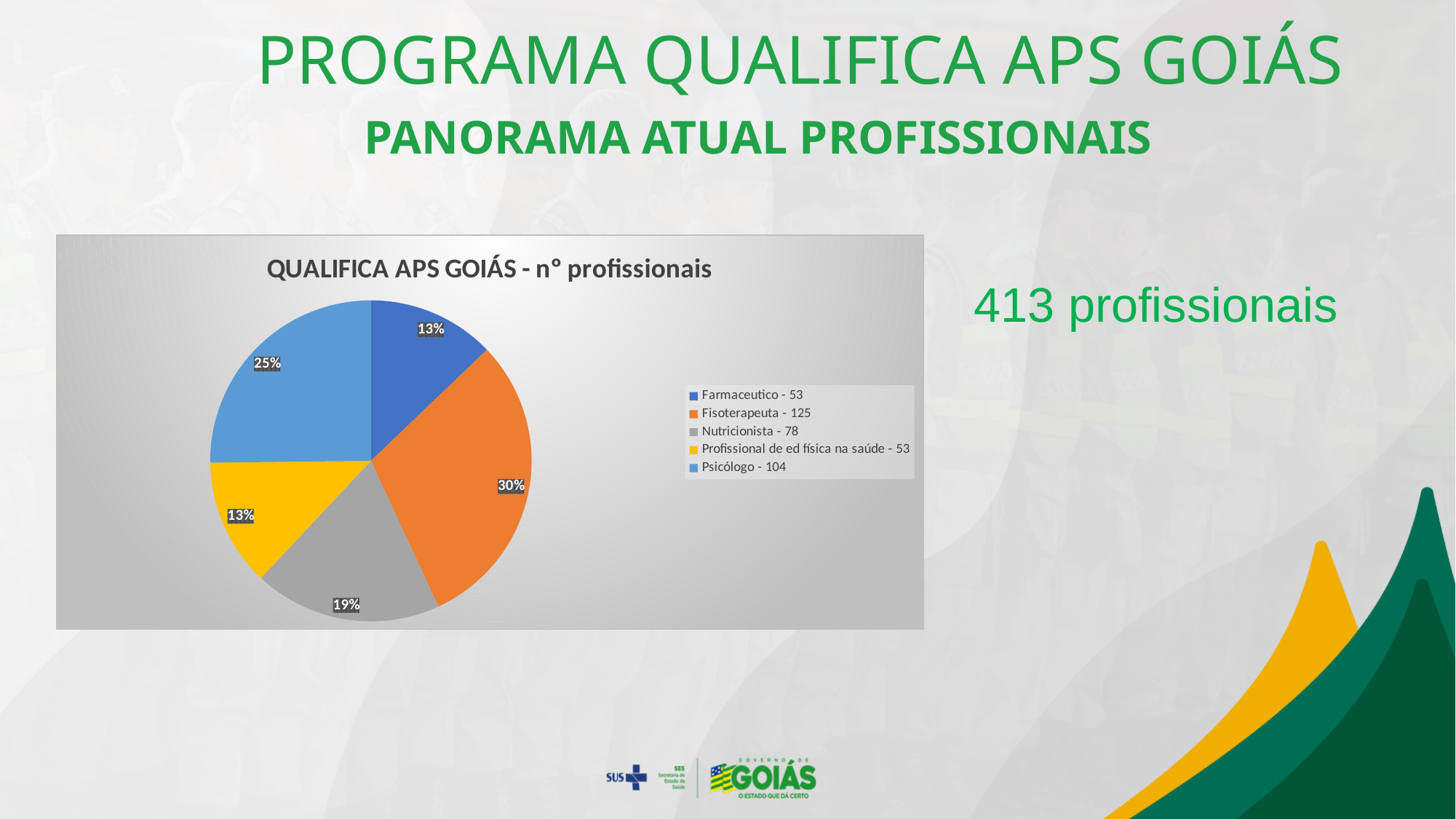
What is the difference between the number of Fisoterapeuta and Nutricionista professionals? 47 What colour is the Fisoterapeuta slice? orange What share of the pie does Nutricionista represent? 19% Which is larger, the number of Psicólogo professionals or the number of Nutricionista professionals? Psicólogo What number of professionals does the legend give for Fisoterapeuta? 125 Which category has the largest slice of the pie? Fisoterapeuta How many slices does the pie chart have? 5 What share of the pie does Fisoterapeuta represent? 30% What is the title of the chart? QUALIFICA APS GOIÁS - n° profissionais What kind of chart is shown on the slide? pie chart What number of professionals does the legend give for Psicólogo? 104 What share of the pie does Psicólogo represent? 25%